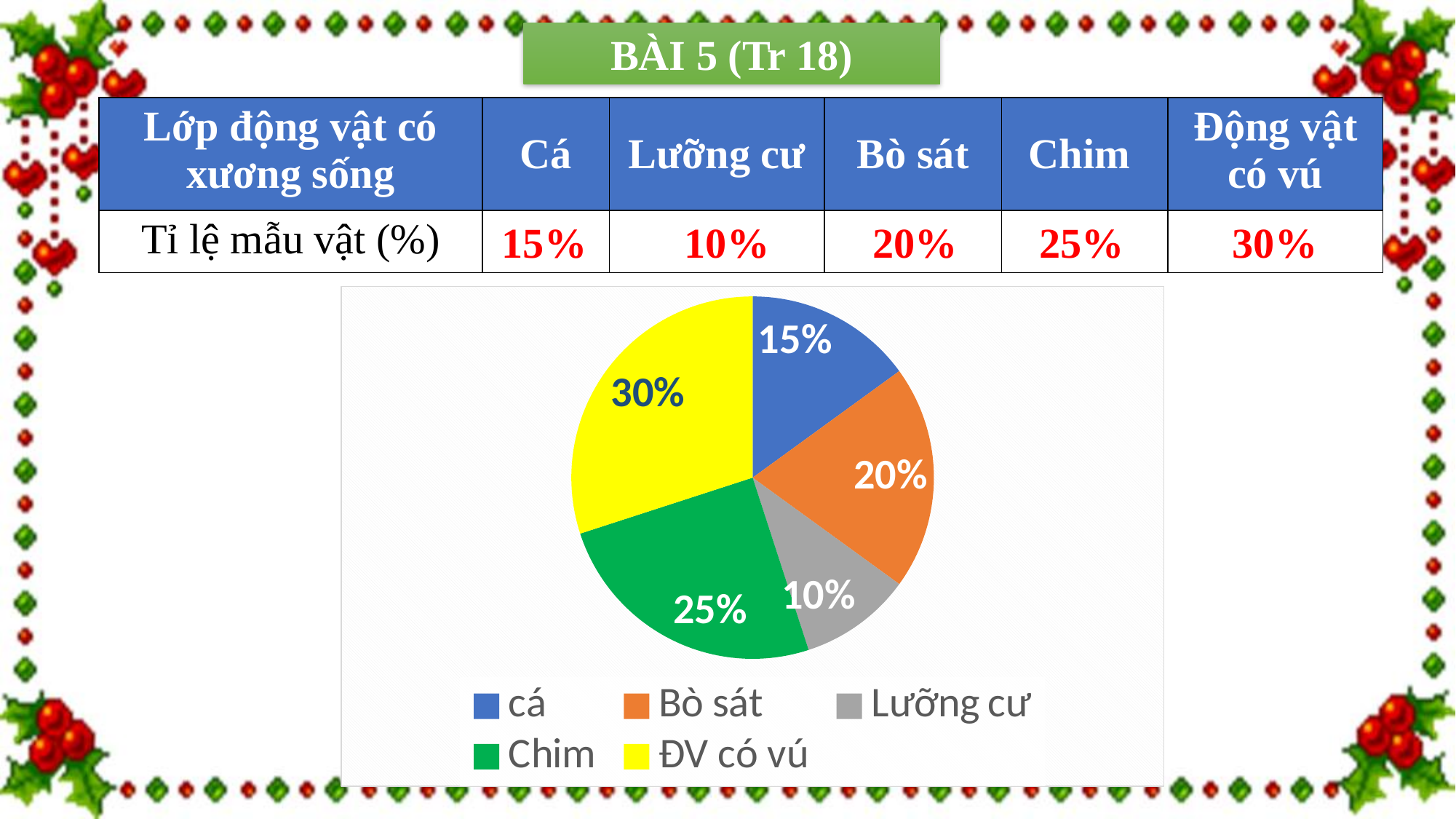
What percentage does the pie chart show for Chim? 25% How many slices does the pie chart have? 5 What percentage does the pie chart show for ĐV có vú? 30% Which is larger in the pie chart, the slice for Chim or the slice for Bò sát? Chim What percentage does the pie chart show for Bò sát? 20% What colour is the slice for Chim in the pie chart? green What percentage does the pie chart show for cá? 15% What is the difference between the percentages for ĐV có vú and cá in the pie chart? 15% What type of chart is shown on the slide? pie chart What percentage does the pie chart show for Lưỡng cư? 10% Which category has the smallest slice in the pie chart? Lưỡng cư Which category has the largest slice in the pie chart? ĐV có vú